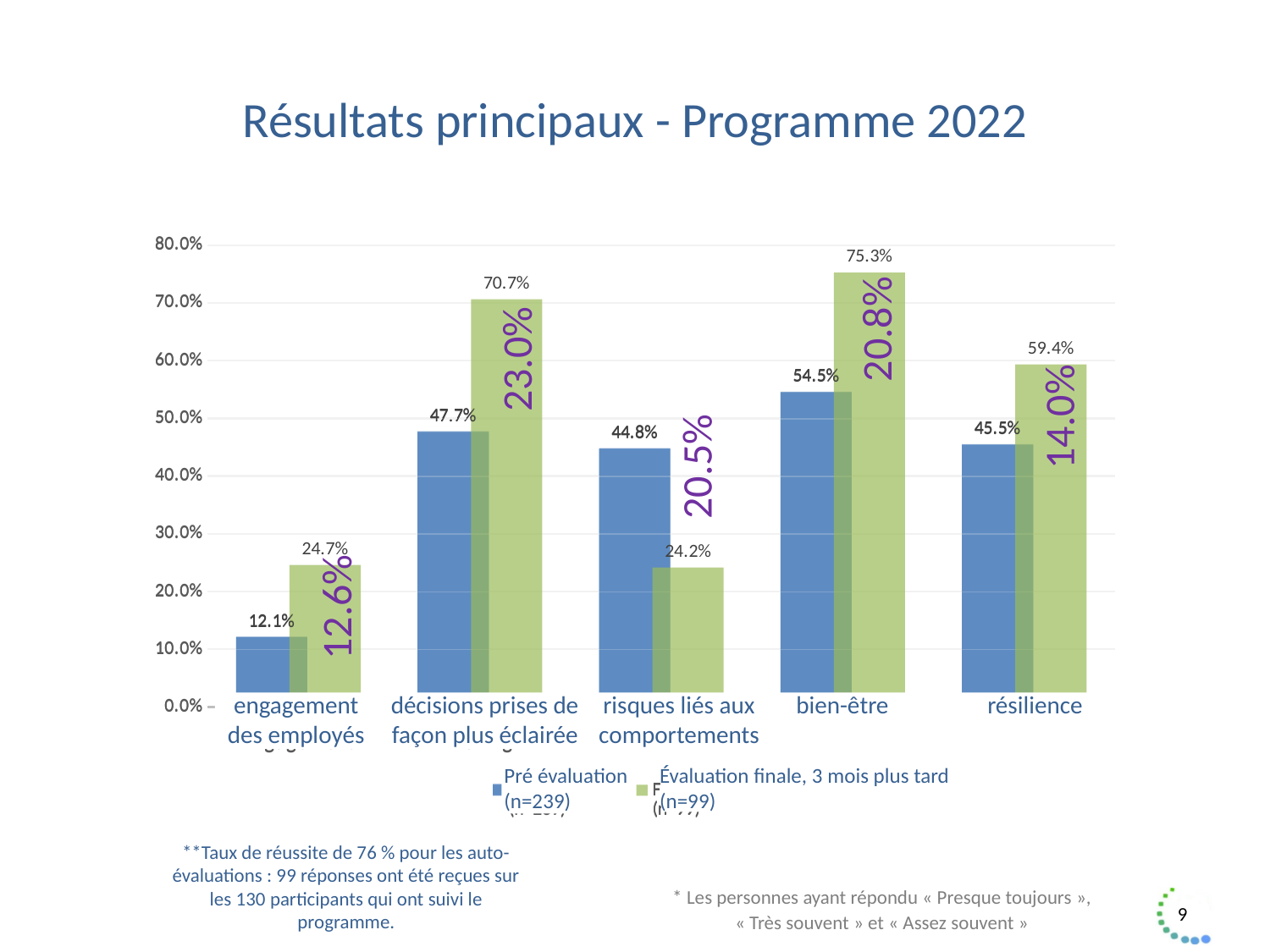
Which category has the highest Évaluation finale, 3 mois plus tard (n=99) value? bien-être How many categories are shown on the x axis? 5 What is the title of the chart slide? Résultats principaux - Programme 2022 How many series does the legend list? 2 What type of chart is shown on the slide? bar chart What is the difference between the Évaluation finale and Pré évaluation values for décisions prises de façon plus éclairée? 23.0% What is the Pré évaluation (n=239) value for engagement des employés? 12.1% What is the Évaluation finale, 3 mois plus tard (n=99) value for bien-être? 75.3% What is the Pré évaluation (n=239) value for risques liés aux comportements? 44.8% For risques liés aux comportements, which is larger: the Pré évaluation value or the Évaluation finale value? Pré évaluation (n=239) Is the Évaluation finale, 3 mois plus tard (n=99) value for résilience greater or less than 50.0%? greater Which category has the lowest Pré évaluation (n=239) value? engagement des employés